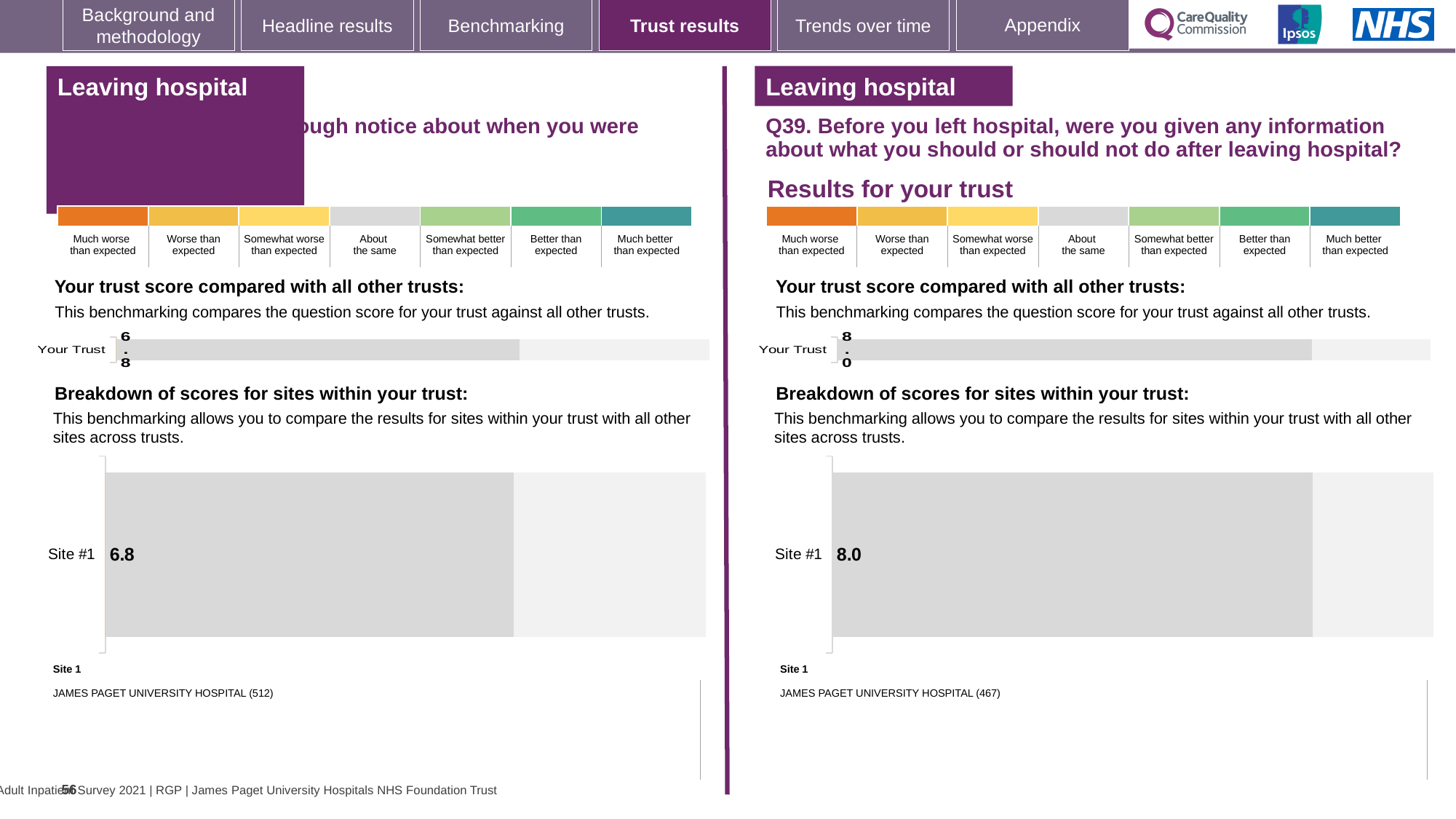
What is the difference between the Site #1 value on the right-hand breakdown chart (Q39) and the Site #1 value on the left-hand breakdown chart? 1.2 On the left-hand side of the slide, what number in brackets follows JAMES PAGET UNIVERSITY HOSPITAL in the Site 1 label? 512 How many sites are plotted on the left-hand 'Breakdown of scores for sites within your trust' chart? 1 On the left-hand 'Your trust score compared with all other trusts' chart, what is the value for Your Trust? 6.8 What kind of chart is used for the Site #1 breakdown on the right-hand side of the slide? bar chart On the right-hand 'Breakdown of scores for sites within your trust' chart (Q39), what is the value for Site #1? 8.0 How many categories are plotted on the right-hand 'Your trust score compared with all other trusts' chart? 1 On the right-hand side of the slide, which hospital is listed as Site 1 below the breakdown chart? JAMES PAGET UNIVERSITY HOSPITAL (467) On the right-hand 'Your trust score compared with all other trusts' chart (Q39), what is the value for Your Trust? 8.0 Which is larger: the Site #1 value on the left-hand breakdown chart or the Site #1 value on the right-hand breakdown chart (Q39)? the right-hand chart (Q39) On the left-hand 'Breakdown of scores for sites within your trust' chart, what is the value for Site #1? 6.8